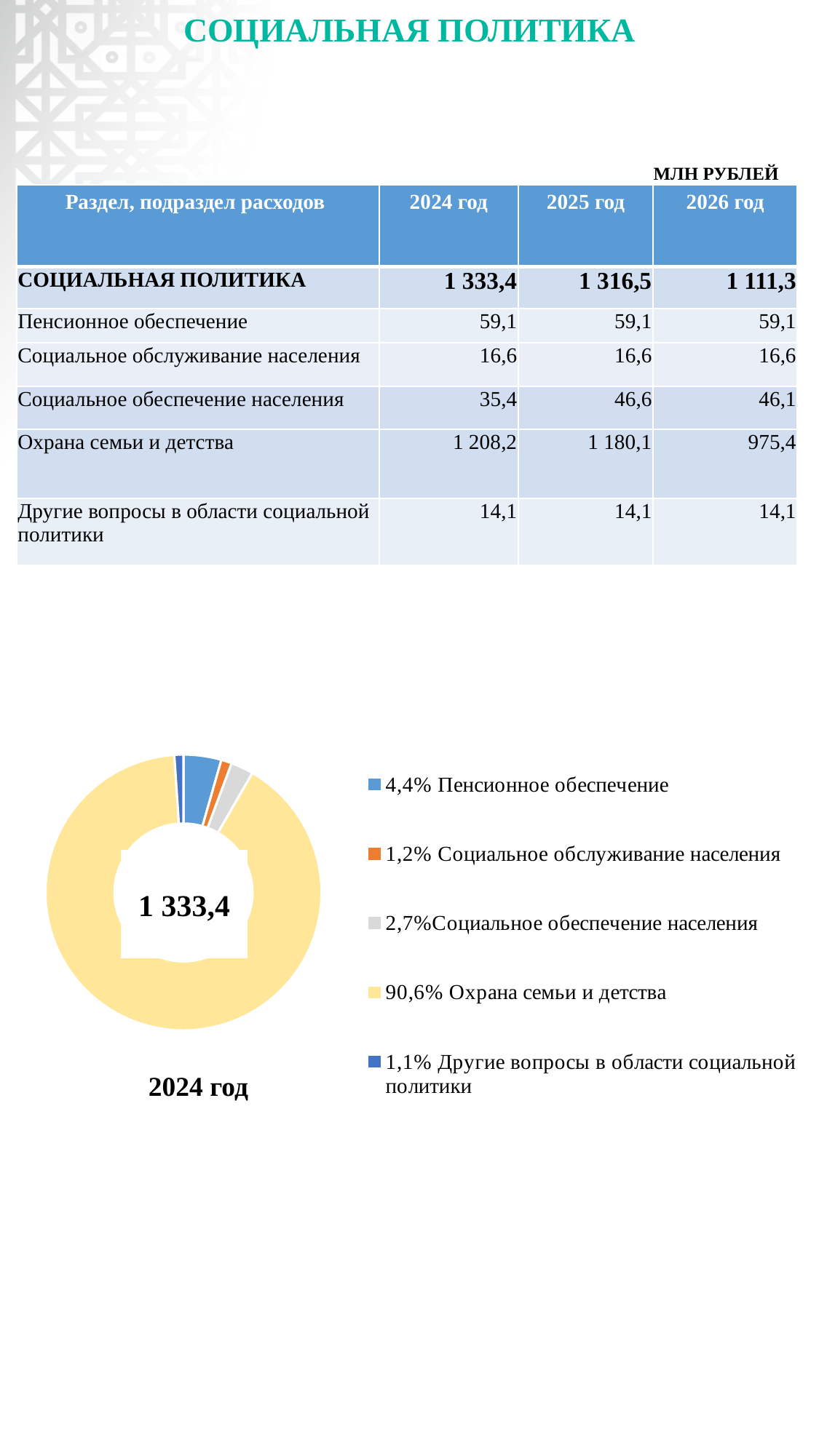
What share of the pie chart does Социальное обслуживание населения take? 1,2% Which category has the smallest slice in the pie chart? Другие вопросы в области социальной политики What share of the pie chart does Пенсионное обеспечение take? 4,4% Which slice is larger in the pie chart: Пенсионное обеспечение or Социальное обеспечение населения? Пенсионное обеспечение What share of the pie chart does Социальное обеспечение населения take? 2,7% Which category has the largest slice in the pie chart? Охрана семьи и детства By how many percentage points does the share of Пенсионное обеспечение exceed that of Социальное обслуживание населения in the pie chart? 3,2% What total value is shown in the centre of the pie chart? 1 333,4 What kind of chart is shown on the slide? Pie chart (doughnut) How many slices does the pie chart have? 5 Which year does the pie chart represent? 2024 год